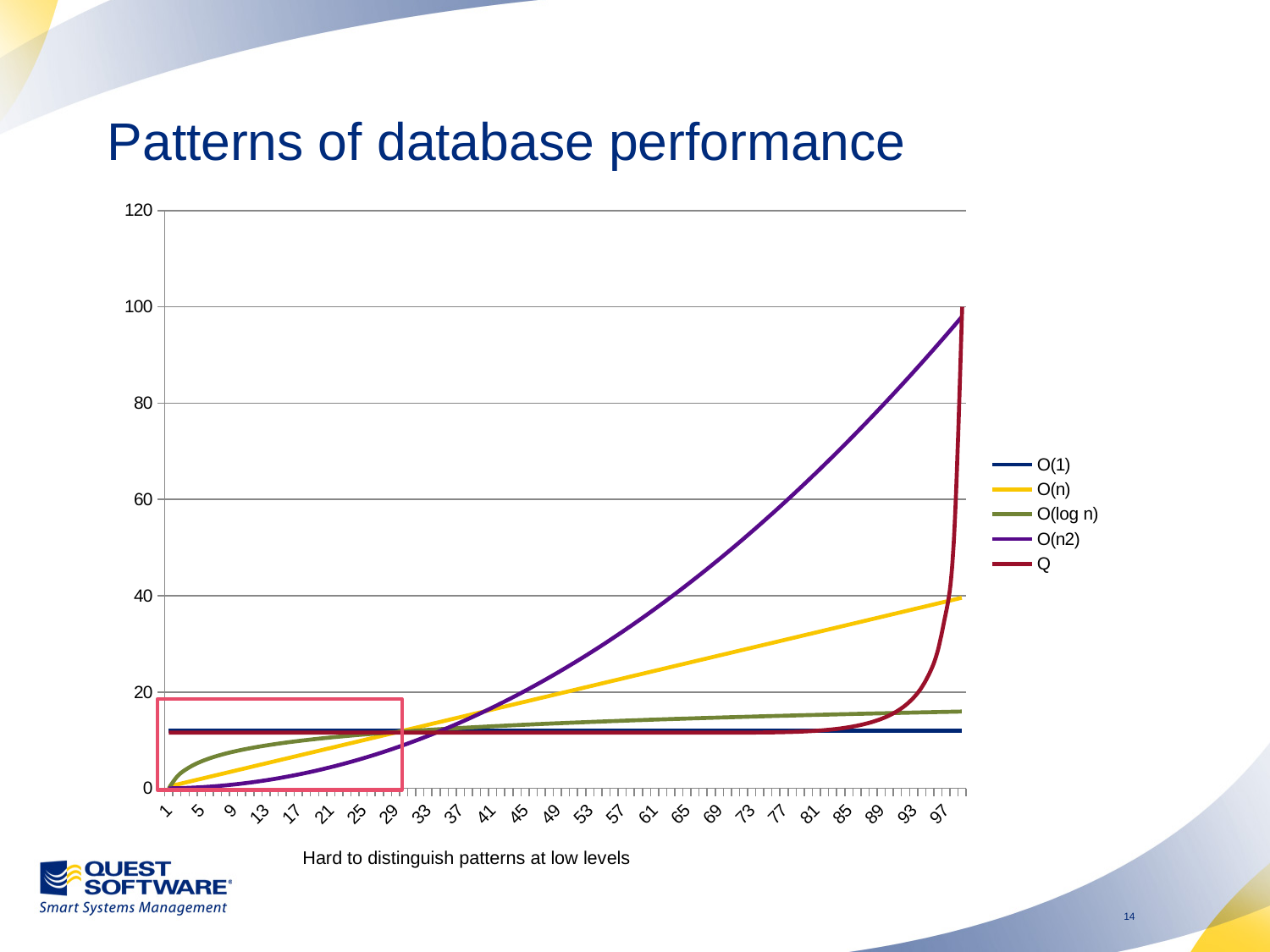
Is the value of the O(n) series at x = 97 greater or less than 60? less Is the value of the Q series at x = 85 greater or less than 40? less Which series stays constant across the whole x axis? O(1) At x = 97, which is larger: the O(n) series or the O(log n) series? O(n) Is the value of the O(1) series greater or less than 20? less At x = 97, which is larger: the O(n2) series or the O(n) series? O(n2) How many series does the legend list? 5 What is the title of the slide containing the chart? Patterns of database performance What kind of chart is shown on the slide? line chart Which series are listed in the legend? O(1), O(n), O(log n), O(n2), Q Does the O(n2) series rise or fall as x increases? rise